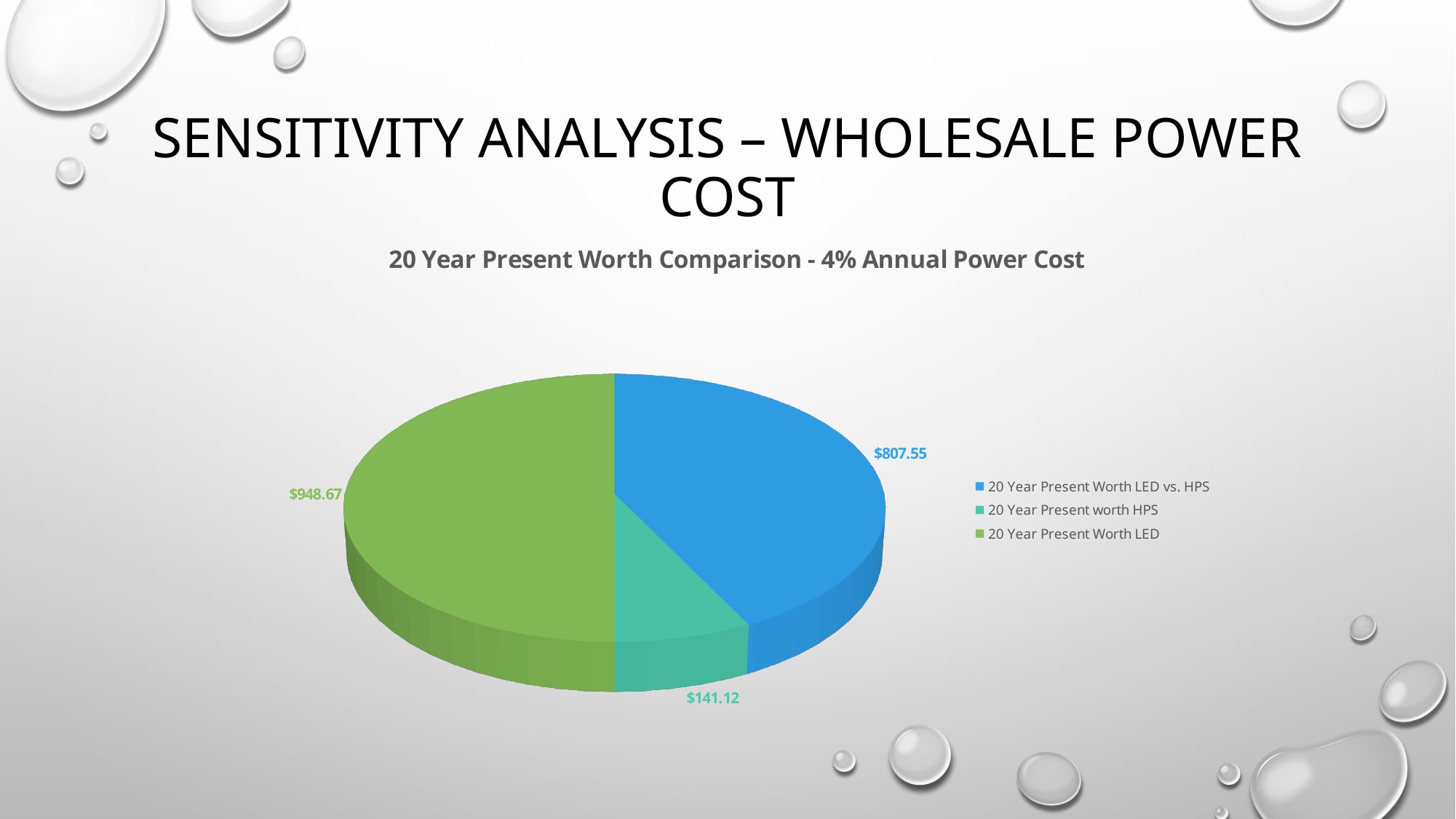
What is the value of the 20 Year Present Worth LED vs. HPS slice? $807.55 What is the title of the chart? 20 Year Present Worth Comparison - 4% Annual Power Cost What is the value of the 20 Year Present worth HPS slice? $141.12 What is the difference between the 20 Year Present Worth LED value and the 20 Year Present Worth LED vs. HPS value? $141.12 Which is larger, the 20 Year Present Worth LED vs. HPS value or the 20 Year Present worth HPS value? 20 Year Present Worth LED vs. HPS What is the value of the 20 Year Present Worth LED slice? $948.67 How many slices does the pie chart have? 3 What is the difference between the 20 Year Present Worth LED vs. HPS value and the 20 Year Present worth HPS value? $666.43 Which slice has the largest value? 20 Year Present Worth LED What colour is the 20 Year Present Worth LED slice? Green What type of chart is shown on the slide? Pie chart Which slice has the smallest value? 20 Year Present worth HPS